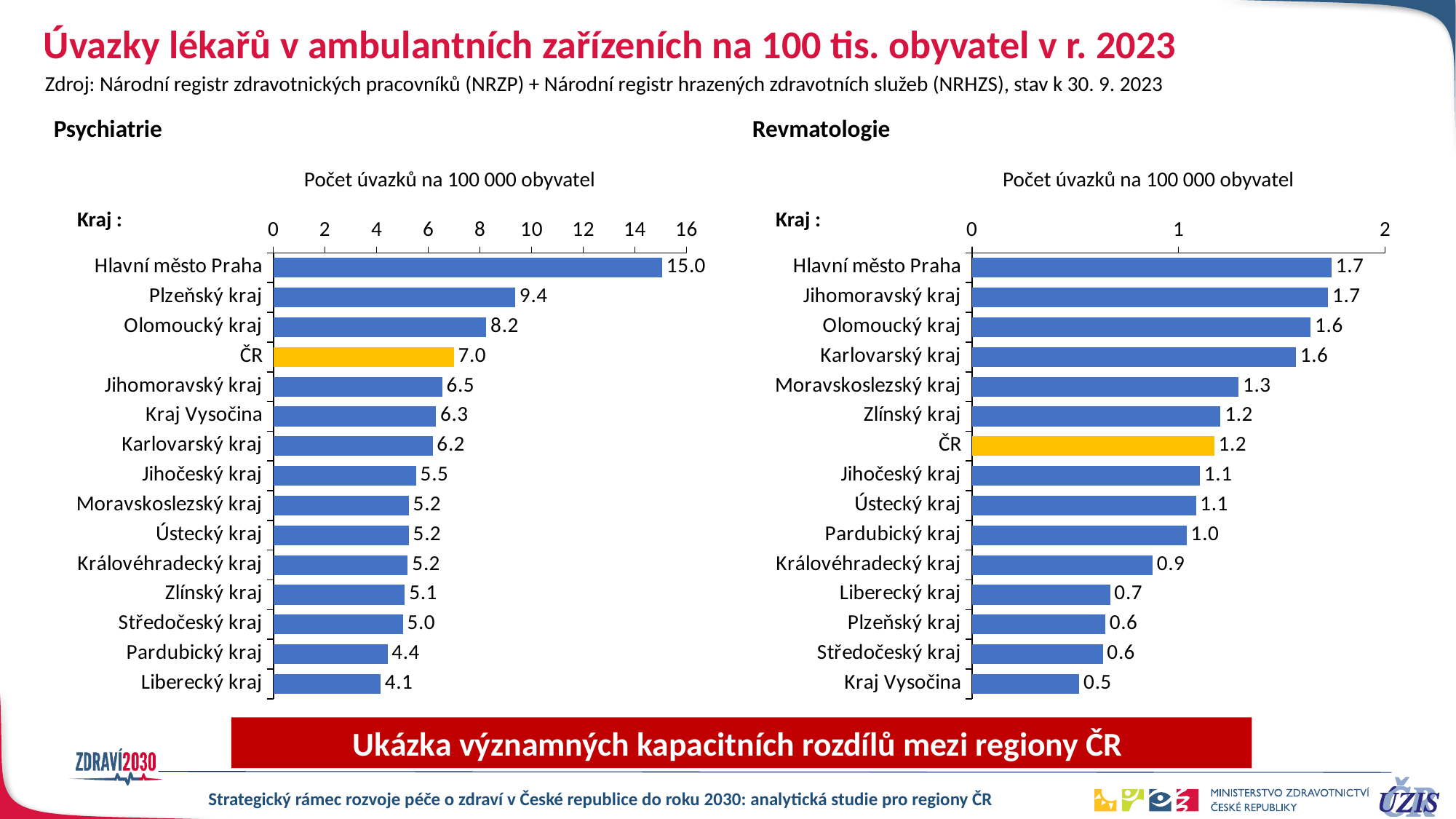
In the Revmatologie chart, which is larger, Pardubický kraj or Liberecký kraj? Pardubický kraj In the Psychiatrie chart, what colour is the bar for ČR? Yellow In the Psychiatrie chart, which region has the highest value? Hlavní město Praha In the Psychiatrie chart, what is the difference between Plzeňský kraj and Olomoucký kraj? 1.2 In the Psychiatrie chart, what is the value for ČR? 7.0 In the Revmatologie chart, what is the difference between Hlavní město Praha and ČR? 0.5 In the Psychiatrie chart, what is the value for Hlavní město Praha? 15.0 What type of chart is the Revmatologie chart? Bar chart In the Psychiatrie chart, how many bars are plotted? 15 In the Psychiatrie chart, which region has the lowest value? Liberecký kraj In the Revmatologie chart, which region has the lowest value? Kraj Vysočina In the Revmatologie chart, what is the value for Moravskoslezský kraj? 1.3